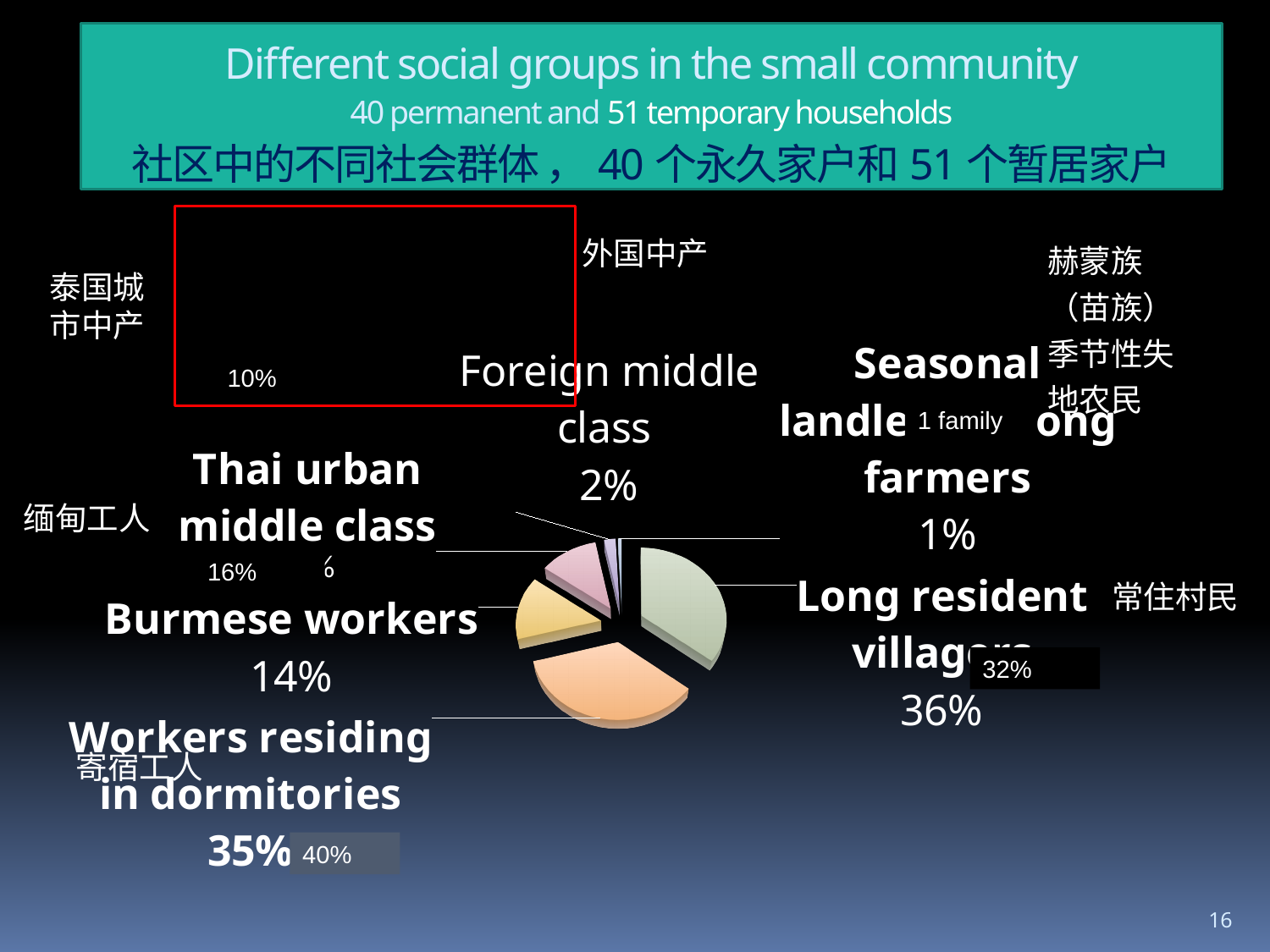
Which social group has the smallest share of the pie? Seasonal landless Hmong farmers What percentage is shown for Burmese workers? 14% Which is larger, the share for Burmese workers or the share for the Foreign middle class? Burmese workers What percentage is shown for Seasonal landless Hmong farmers? 1% According to the slide title, how many permanent and temporary households are in the community? 40 permanent and 51 temporary households What kind of chart is shown on the slide? pie chart What share of the pie is labelled for Long resident villagers? 36% How many percentage points larger is the share for Long resident villagers than the share for Burmese workers? 22% What percentage is shown for the Foreign middle class? 2% Which social group has the largest labelled share of the pie? Long resident villagers How many social groups are shown as slices in the pie chart? 6 What percentage is shown for Workers residing in dormitories? 35%